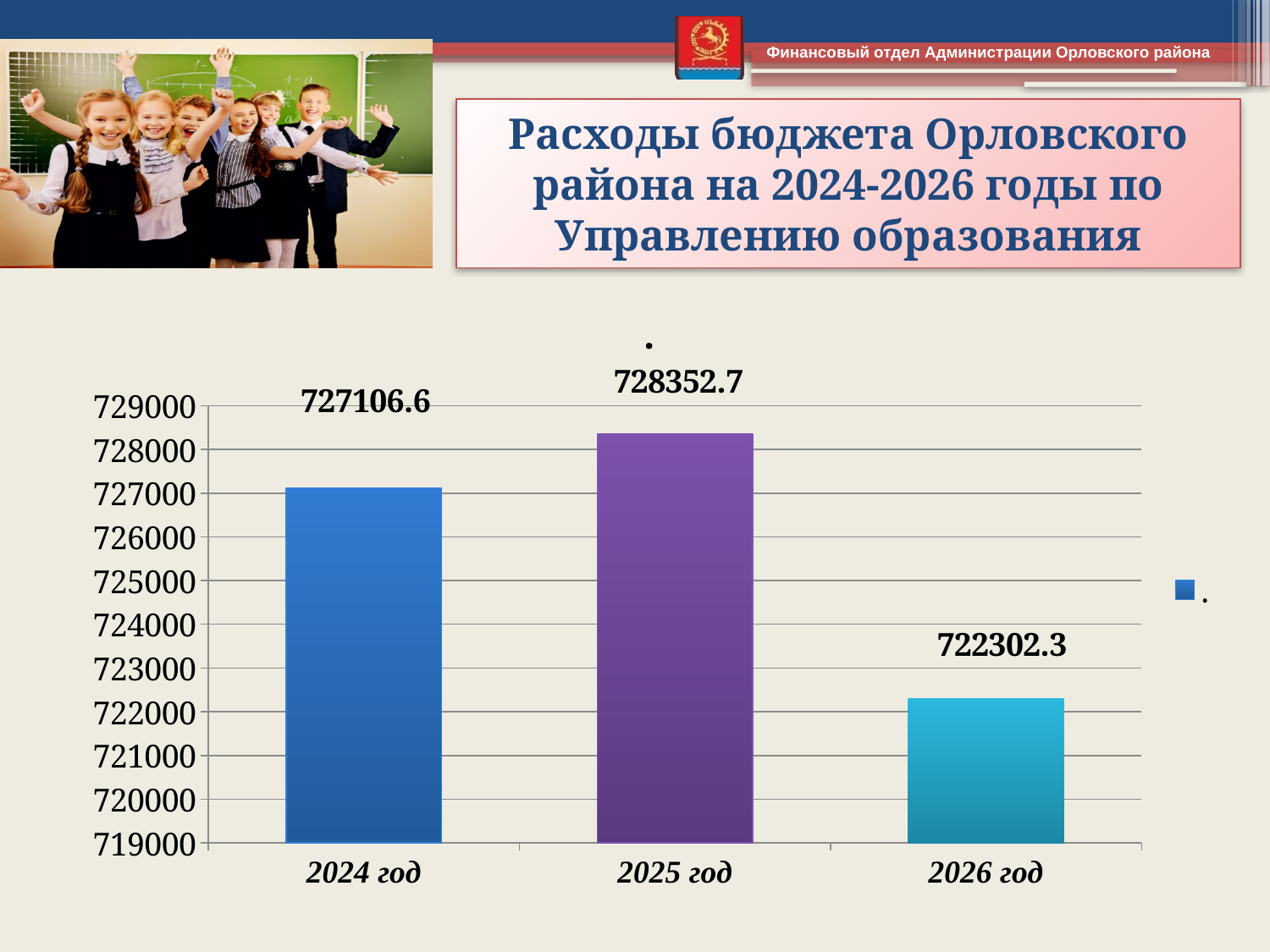
Which year has the highest value? 2025 год How many bars are shown in the chart? 3 What is the value shown for 2025 год? 728352.7 Which is larger, the value for 2024 год or the value for 2026 год? 2024 год What is the difference between the values for 2024 год and 2026 год? 4804.3 What type of chart is shown on the slide? bar chart What is the difference between the values for 2025 год and 2024 год? 1246.1 Do the values rise or fall from 2025 год to 2026 год? fall Is the value for 2026 год greater or less than 723000? less What is the value shown for 2026 год? 722302.3 Which year has the lowest value? 2026 год What is the value shown for 2024 год? 727106.6